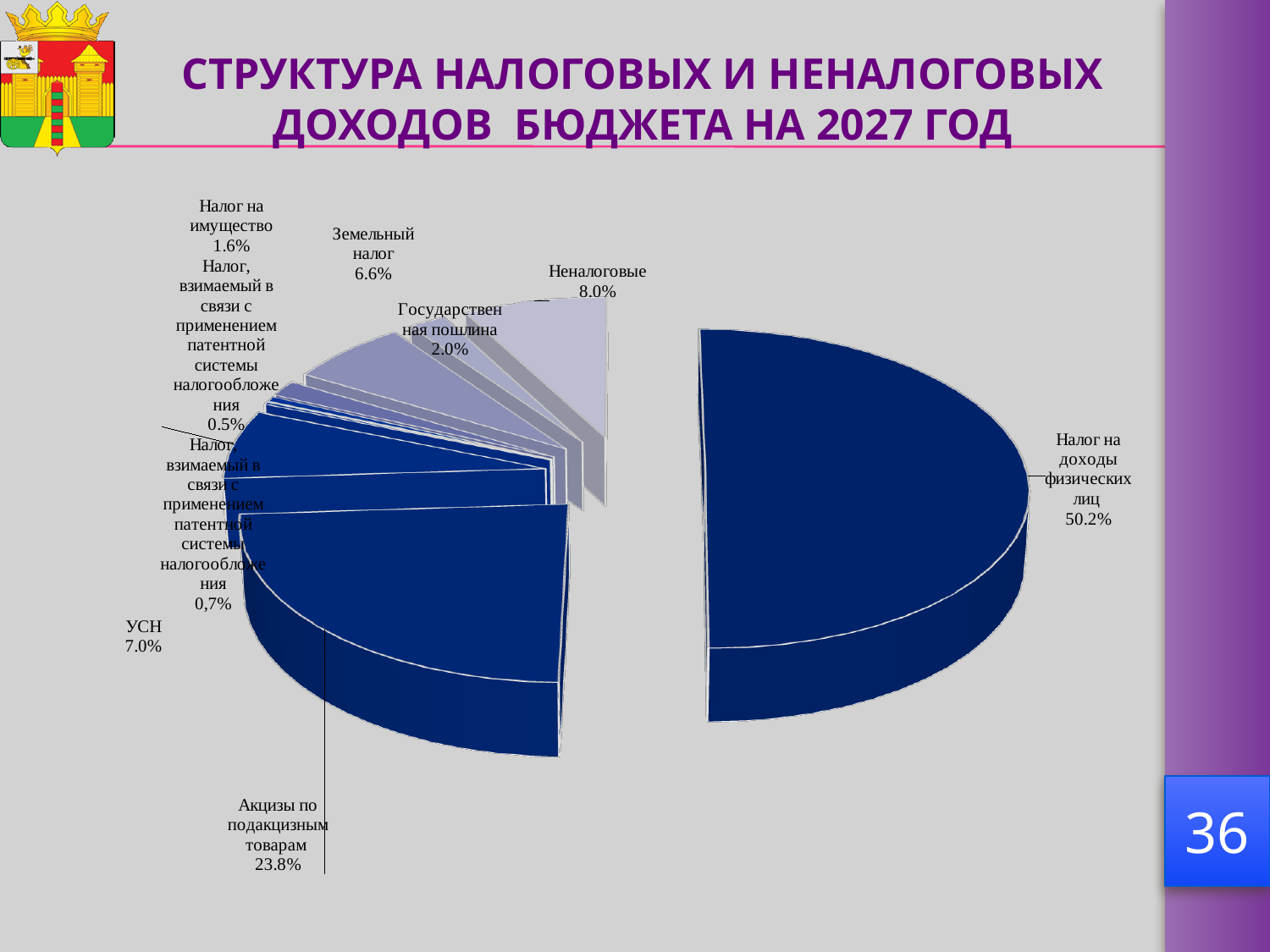
What share is shown for Налог на имущество? 1.6% What is the title of the slide containing the chart? СТРУКТУРА НАЛОГОВЫХ И НЕНАЛОГОВЫХ ДОХОДОВ БЮДЖЕТА НА 2027 ГОД What share is shown for Государственная пошлина? 2.0% What share is shown for Акцизы по подакцизным товарам? 23.8% By how many percentage points does Налог на доходы физических лиц exceed Акцизы по подакцизным товарам? 26.4 What share is shown for УСН? 7.0% What kind of chart is shown on the slide? pie chart What share is shown for Земельный налог? 6.6% What share is shown for Неналоговые revenues? 8.0% Which category has the largest share of the pie? Налог на доходы физических лиц What share of the budget revenues is Налог на доходы физических лиц? 50.2% Which is larger, the share for УСН or the share for Земельный налог? УСН